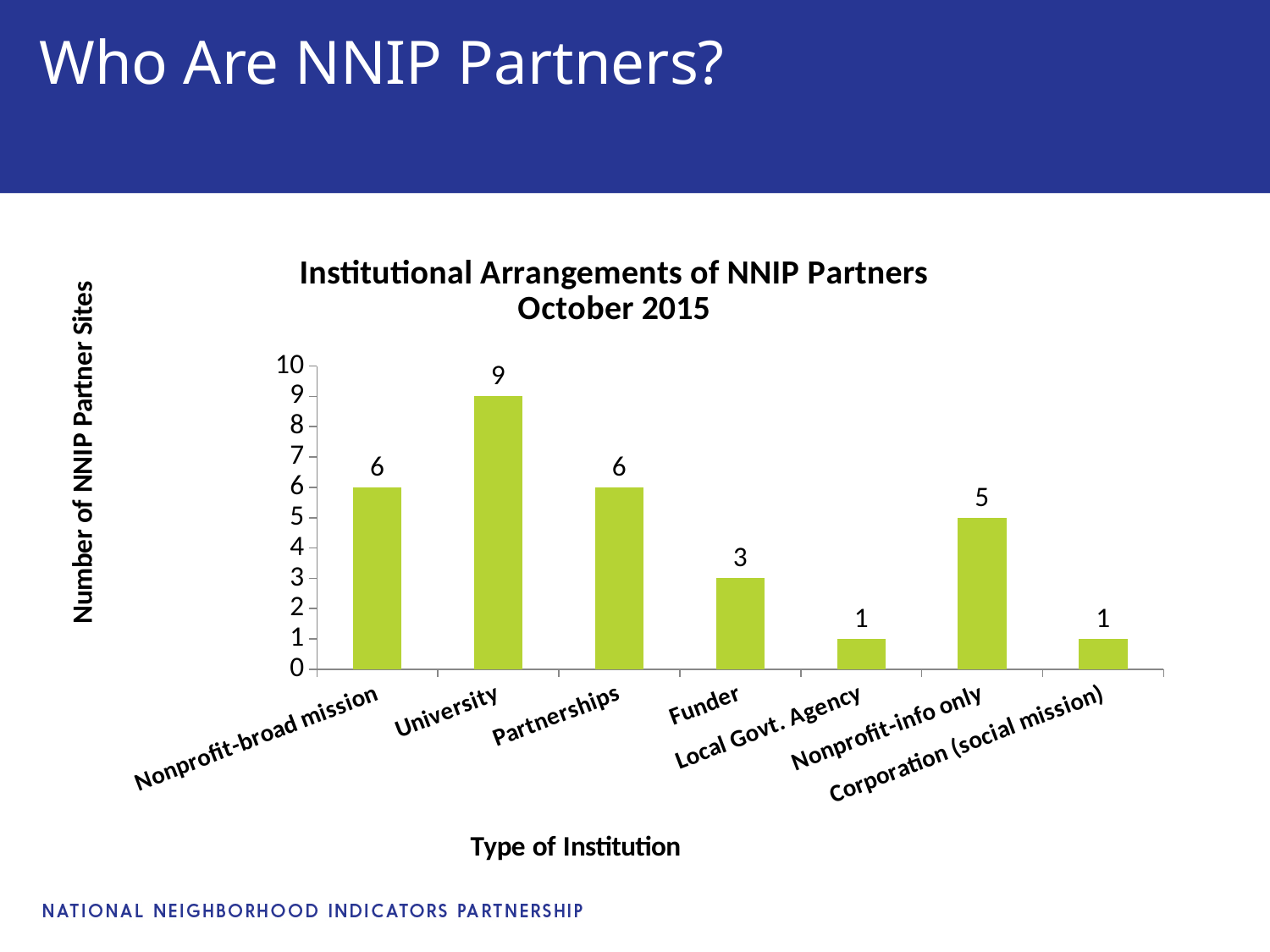
Which has more NNIP partner sites, Nonprofit-broad mission or Nonprofit-info only? Nonprofit-broad mission What kind of chart is shown on the slide? Bar chart Which type of institution has the highest number of NNIP partner sites? University What is the difference between the number of partner sites for Nonprofit-info only and for Funder? 2 What is the title of the chart? Institutional Arrangements of NNIP Partners October 2015 What is the number of NNIP partner sites for Nonprofit-info only? 5 What is the number of NNIP partner sites for University? 9 How many types of institution are shown on the x axis? 7 What is the difference between the number of partner sites for University and for Partnerships? 3 Is the value for University greater or less than 8? greater What is the number of NNIP partner sites for Local Govt. Agency? 1 What is the number of NNIP partner sites for Funder? 3